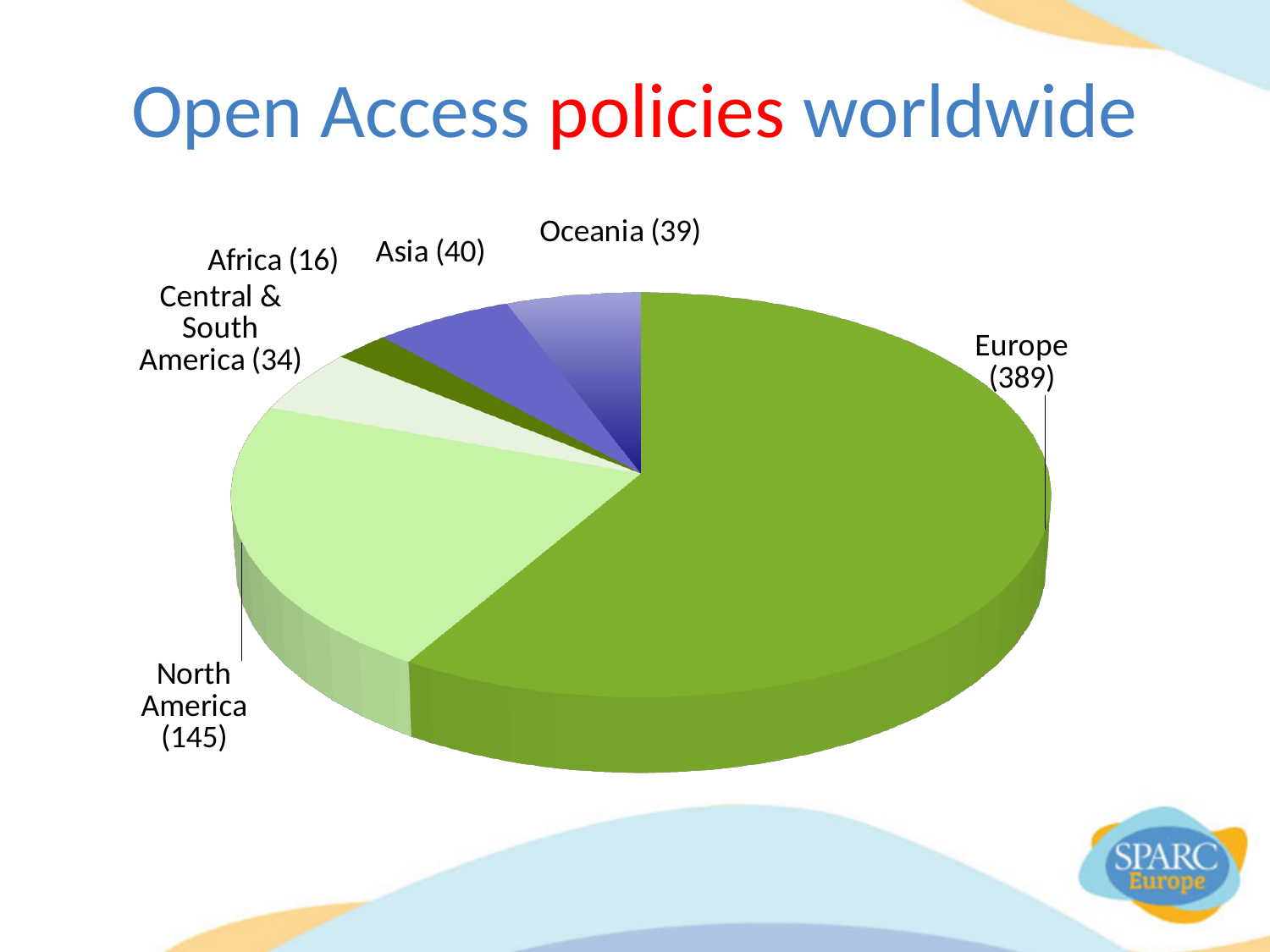
Which region has the largest slice of the pie? Europe Which is larger, the value for Asia or the value for Africa? Asia What kind of chart is shown on the slide? Pie chart What is the title of the slide? Open Access policies worldwide Which region has the smallest slice of the pie? Africa What is the value for Africa? 16 How many regions are shown in the pie chart? 6 What is the value for North America? 145 What is the value for Central & South America? 34 What is the difference between the values for Europe and North America? 244 What is the value for Europe? 389 What is the value for Oceania? 39